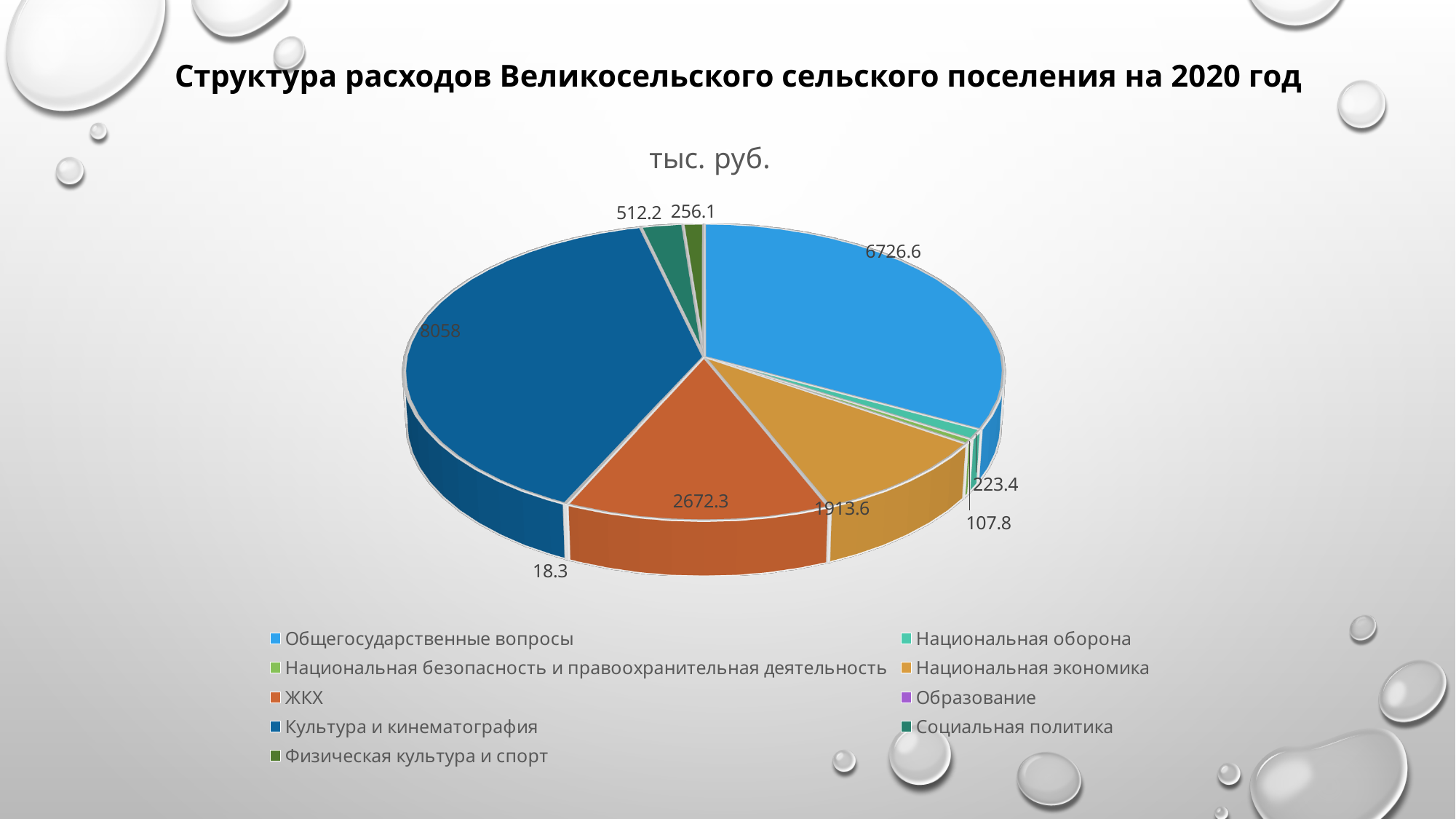
How many categories does the legend list? 9 Which category has the largest slice of the pie? Культура и кинематография What is the title shown above the pie chart? тыс. руб. What is the value for Общегосударственные вопросы? 6726.6 What is the difference between the values for Культура и кинематография and Общегосударственные вопросы? 1331.4 Which is larger, the value for ЖКХ or the value for Национальная экономика? ЖКХ What is the value for Социальная политика? 512.2 What is the value for ЖКХ? 2672.3 What is the smallest value labelled on the pie chart? 18.3 What is the value for Национальная экономика? 1913.6 What kind of chart is shown on the slide? Pie chart What is the value for Культура и кинематография? 8058